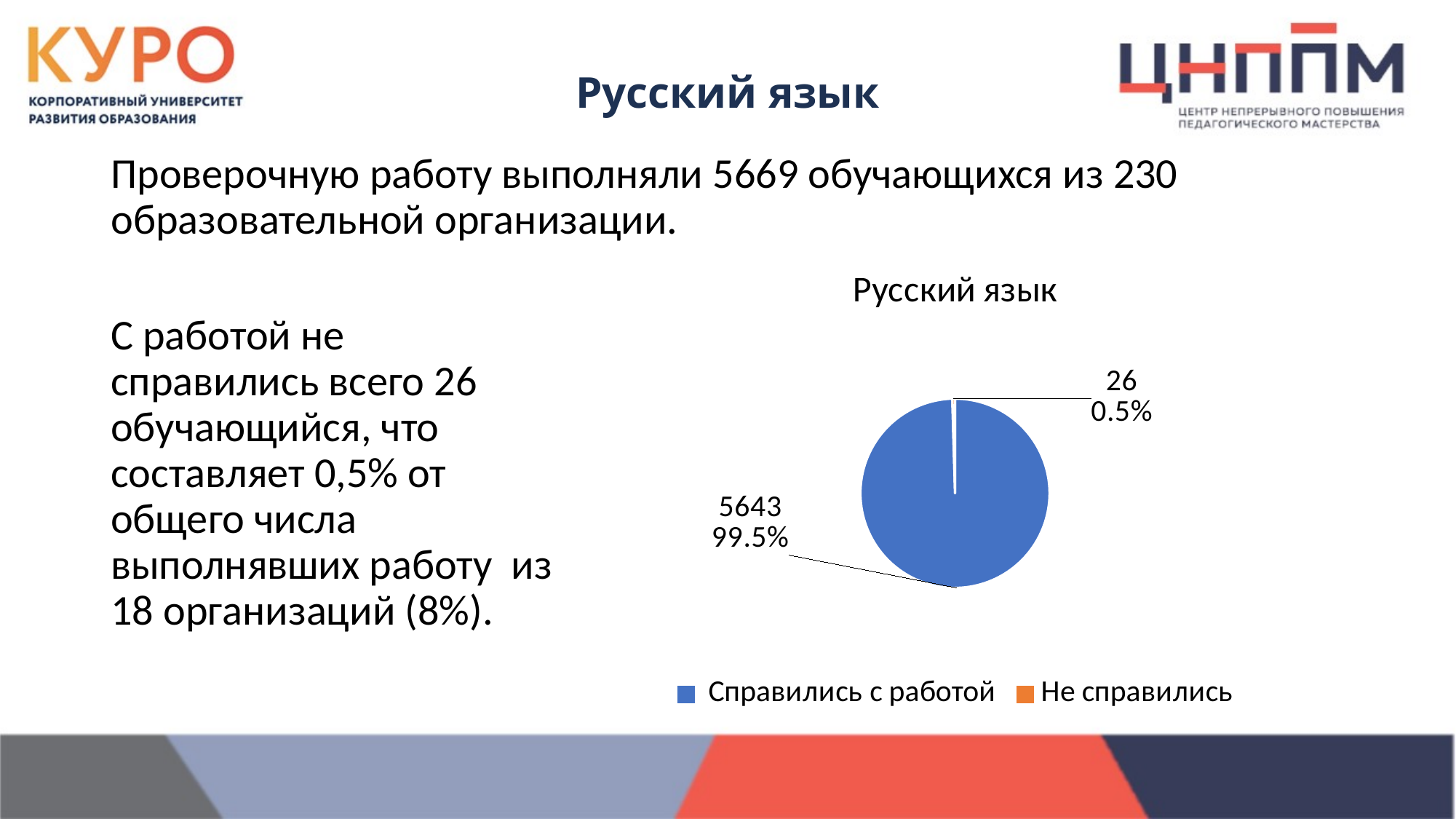
Which category has the smallest slice in the pie chart? Не справились Which category has the largest slice in the pie chart? Справились с работой What share of the pie does "Справились с работой" take? 99.5% How many slices does the pie chart have? 2 What is the value for "Не справились" in the pie chart? 26 What is the value for "Справились с работой" in the pie chart? 5643 How many entries does the chart legend list? 2 What is the difference between the values for "Справились с работой" and "Не справились"? 5617 What kind of chart is shown on the slide? pie chart Which colour represents "Не справились" in the legend? orange What share of the pie does "Не справились" take? 0.5% What is the title of the chart? Русский язык